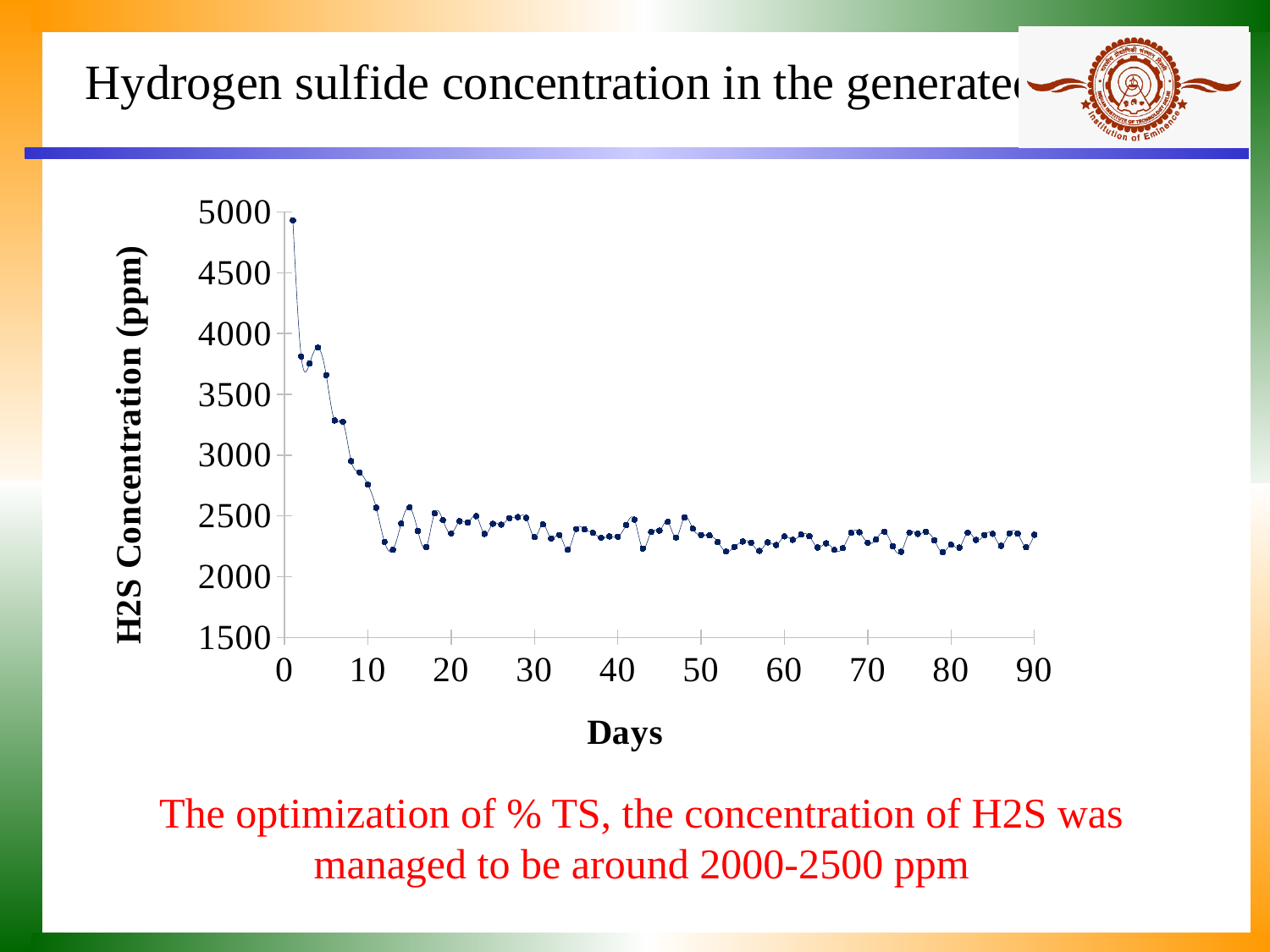
Is the H2S concentration on day 7 greater or less than 3500 ppm? less What kind of chart is shown on the slide? line chart Is the H2S concentration on day 2 greater or less than 3500 ppm? greater Is the H2S concentration on day 10 greater or less than 3000 ppm? less On which day is the H2S concentration highest? Day 1 Which is larger, the H2S concentration on day 1 or on day 90? Day 1 What is the label of the x-axis? Days Do the H2S concentration values generally rise or fall as the days increase? fall What is the label of the y-axis? H2S Concentration (ppm) Which is larger, the H2S concentration on day 5 or on day 10? Day 5